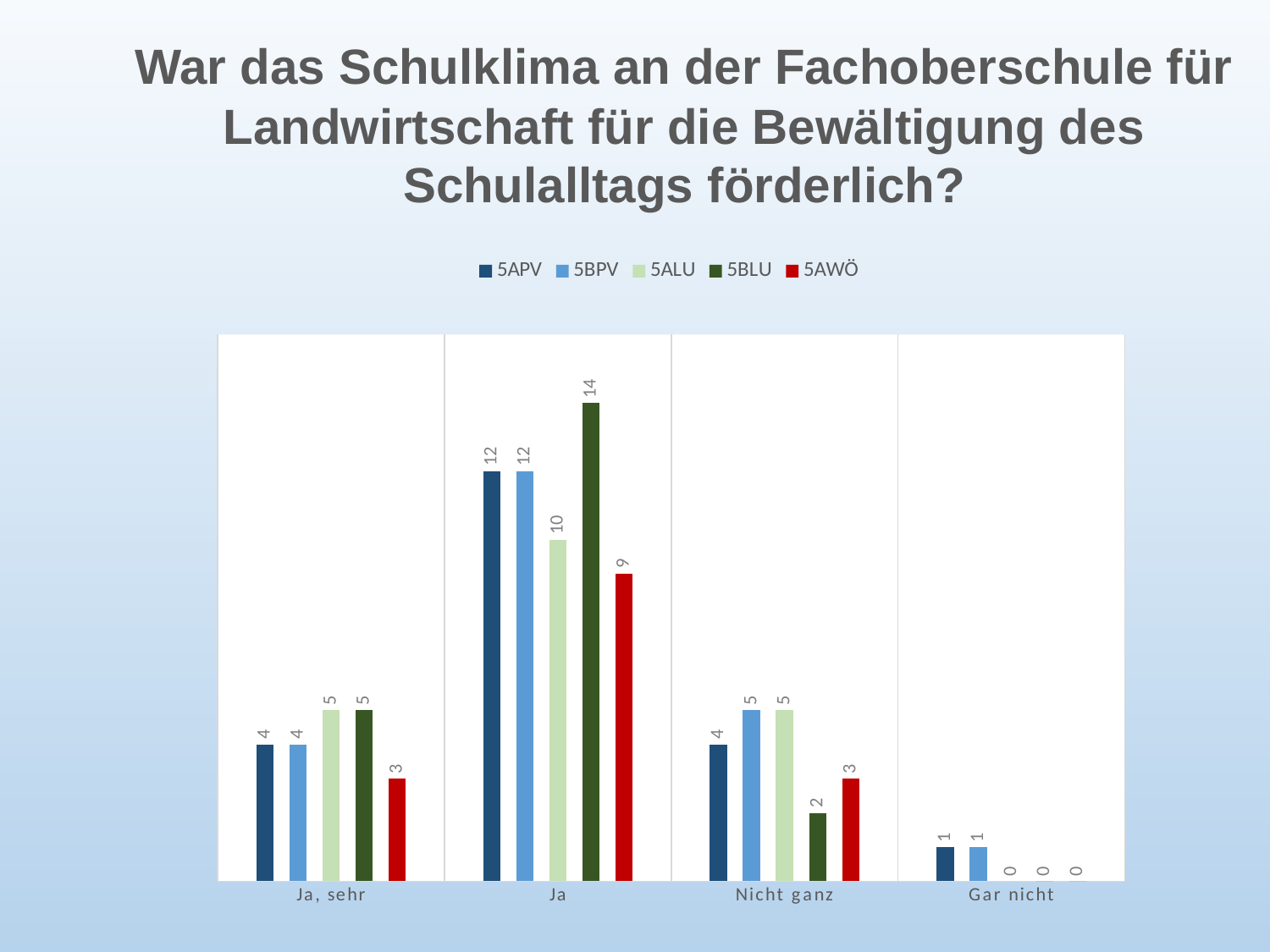
Which is larger in the "Ja, sehr" category: the value for 5ALU or the value for 5AWÖ? 5ALU Which series is shown in red in the legend? 5AWÖ What is the difference between the 5BLU and 5AWÖ values in the "Ja" category? 5 Which series has the highest value in the "Ja" category? 5BLU Which series has the lowest value in the "Nicht ganz" category? 5BLU What kind of chart is shown on the slide? bar chart How many series does the legend list? 5 What value does 5BLU have for the category "Ja"? 14 What value does 5AWÖ have for the category "Ja, sehr"? 3 How many categories are shown on the x axis? 4 What value does 5ALU have for the category "Nicht ganz"? 5 What value does 5APV have for the category "Gar nicht"? 1